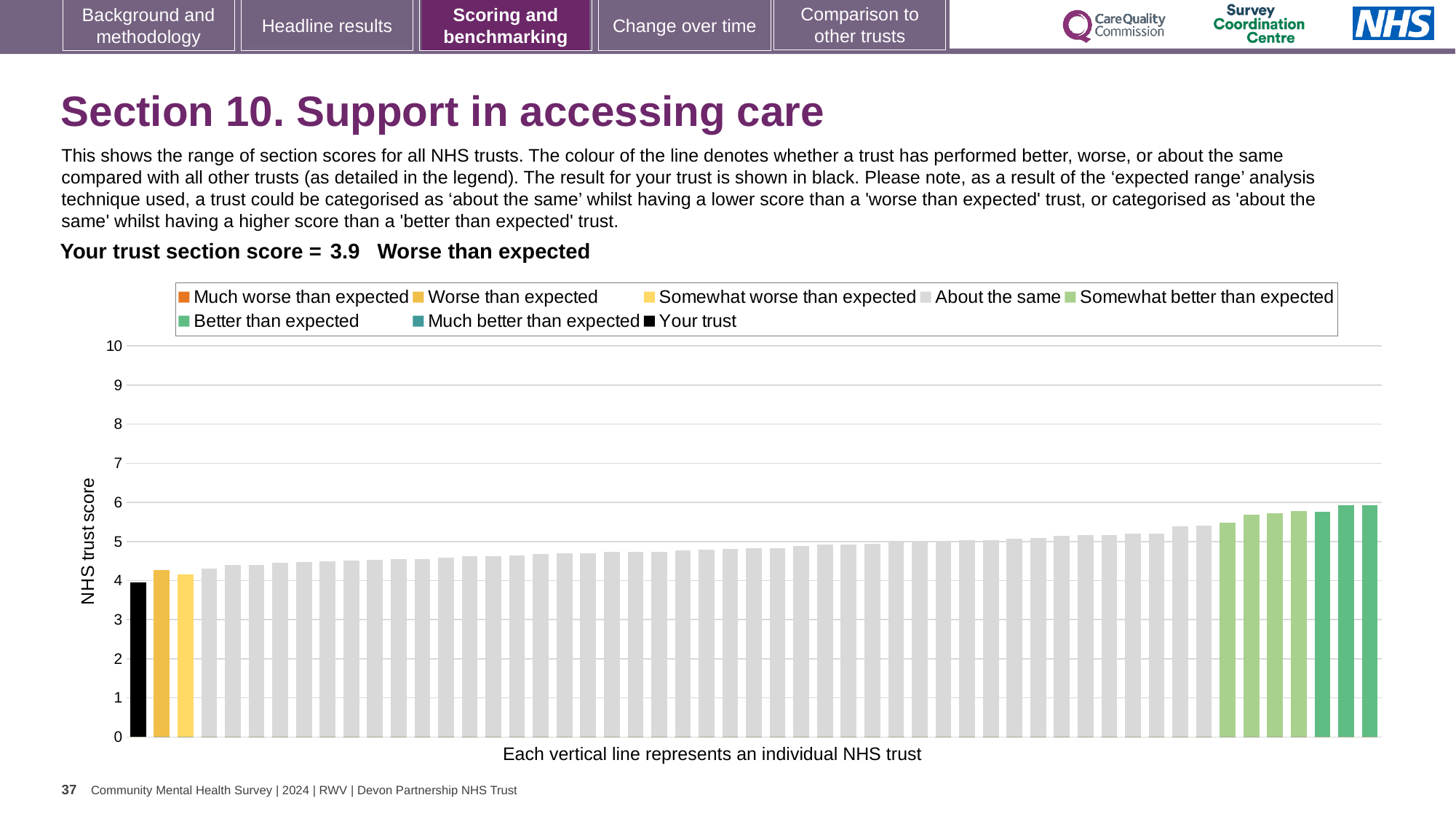
What is the section score for your trust shown on the slide? 3.9 Which category does your trust fall into according to the slide? Worse than expected What kind of chart is shown on the slide? bar chart Is the highest trust score in the chart greater or less than 5? greater Is the highest trust score in the chart greater or less than 7? less What is the label on the vertical axis of the chart? NHS trust score Is the score for your trust greater or less than 5? less Which bar has the lowest score in the chart? Your trust Which is larger: the score for your trust or the score of the rightmost bar? the rightmost bar Do the bar values rise or fall moving from left to right along the x axis? rise How many entries does the chart legend list? 8 What is the maximum value shown on the vertical axis? 10